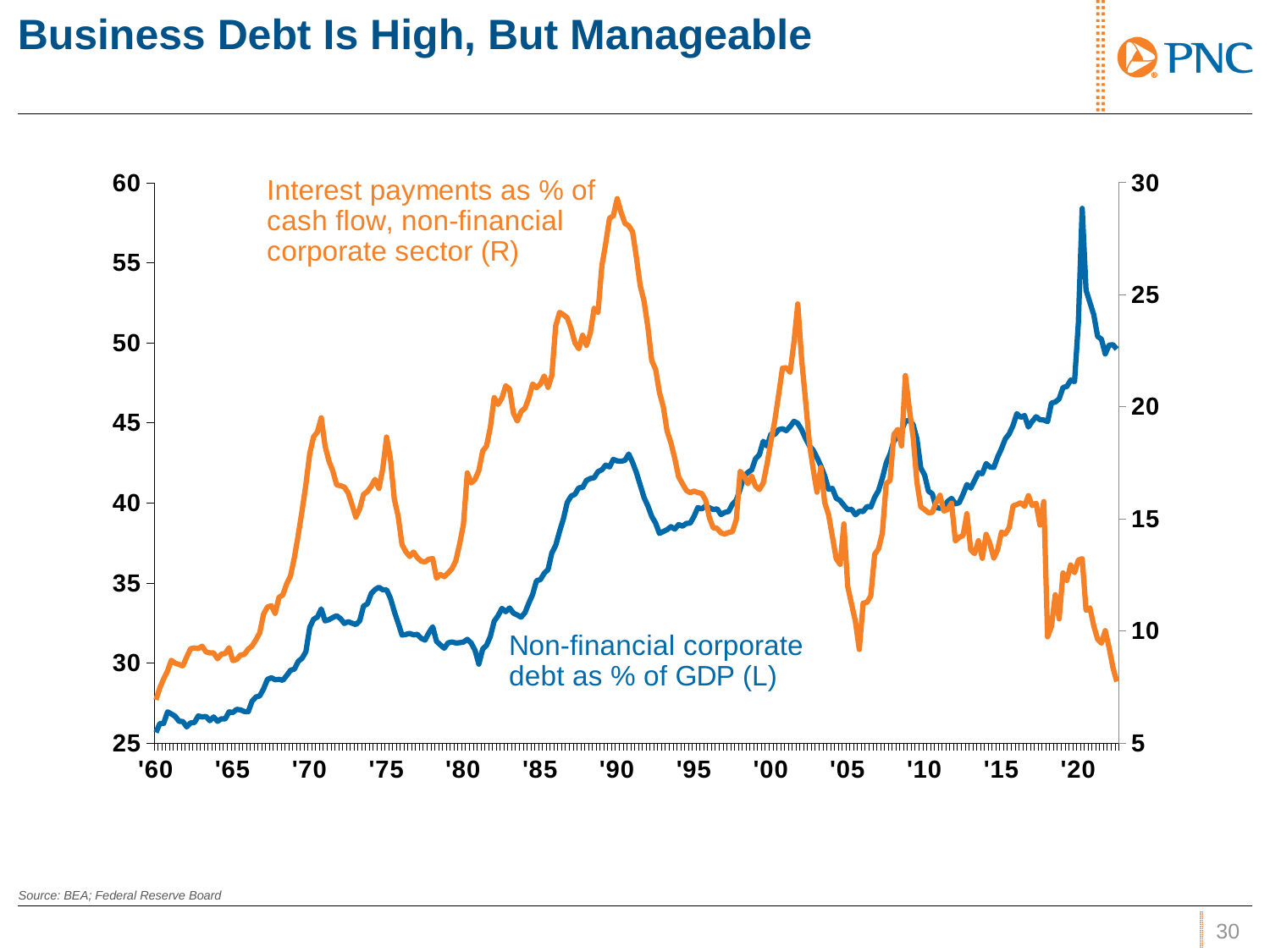
Is the value of interest payments as % of cash flow in '75 greater or less than 15? greater Is the value of interest payments as % of cash flow at the end of the series (after '20) greater or less than 10? less Around which year does the interest payments as % of cash flow series reach its highest value? '90 Which series is plotted against the left axis? Non-financial corporate debt as % of GDP Is the value of non-financial corporate debt as % of GDP in '60 greater or less than 30? less Does the non-financial corporate debt as % of GDP series generally rise or fall from '60 to '20? rise How many data series are plotted on the chart? 2 What kind of chart is shown on the slide? line chart What colour is the line for interest payments as % of cash flow? orange